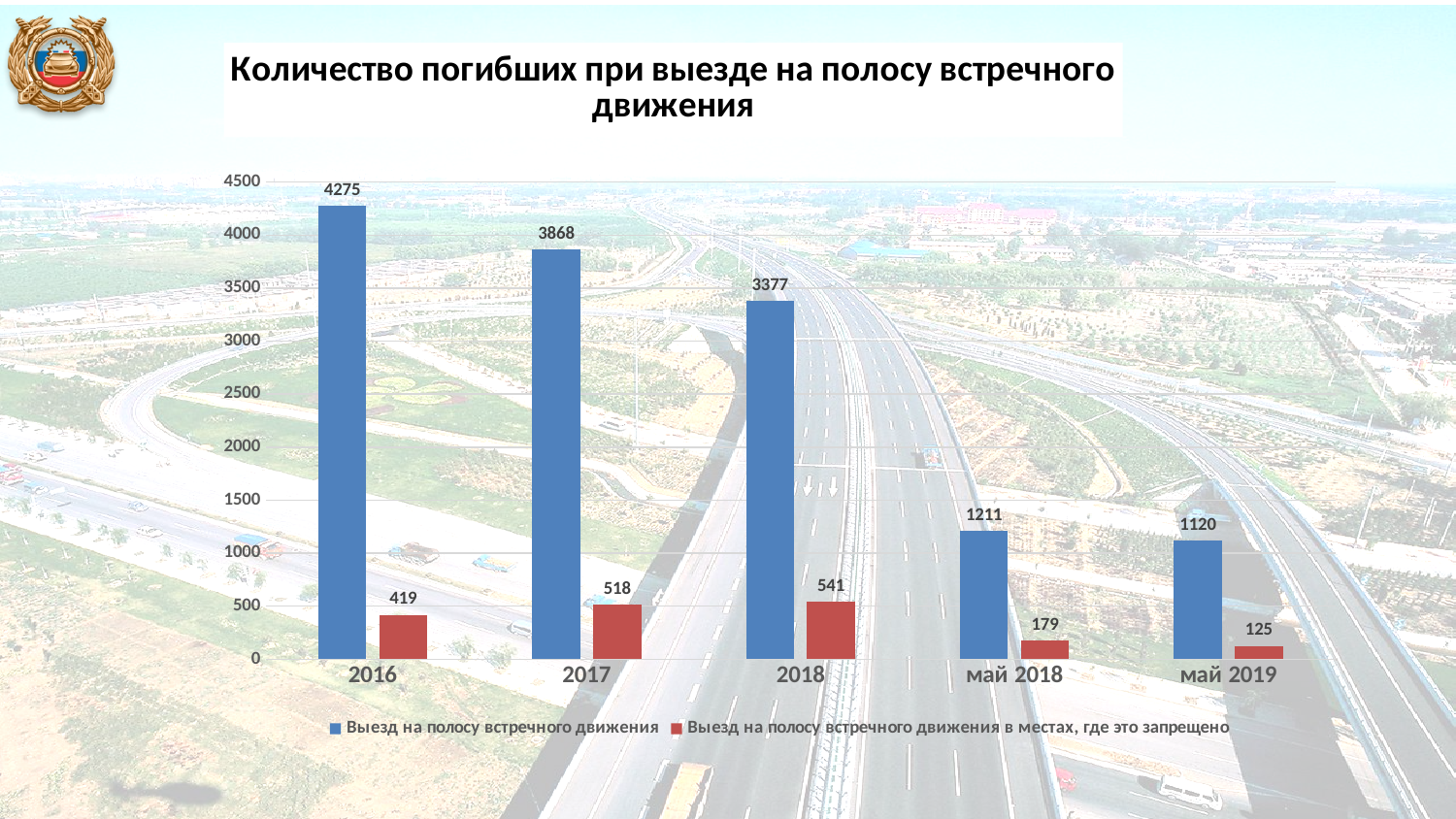
Which category has the highest value in the series "Выезд на полосу встречного движения"? 2016 What is the value for май 2019 in the series "Выезд на полосу встречного движения в местах, где это запрещено"? 125 Which is larger: the 2017 value or the 2018 value in the series "Выезд на полосу встречного движения в местах, где это запрещено"? 2018 How many series does the legend list? 2 What is the difference between the май 2018 and май 2019 values in the series "Выезд на полосу встречного движения в местах, где это запрещено"? 54 What is the value for 2016 in the series "Выезд на полосу встречного движения"? 4275 What is the difference between the 2016 and 2017 values in the series "Выезд на полосу встречного движения"? 407 Is the value for май 2018 in the series "Выезд на полосу встречного движения" greater or less than 1000? greater What is the value for 2018 in the series "Выезд на полосу встречного движения в местах, где это запрещено"? 541 Which category has the lowest value in the series "Выезд на полосу встречного движения в местах, где это запрещено"? май 2019 What kind of chart is shown on the slide? bar chart How many categories are shown on the x axis? 5